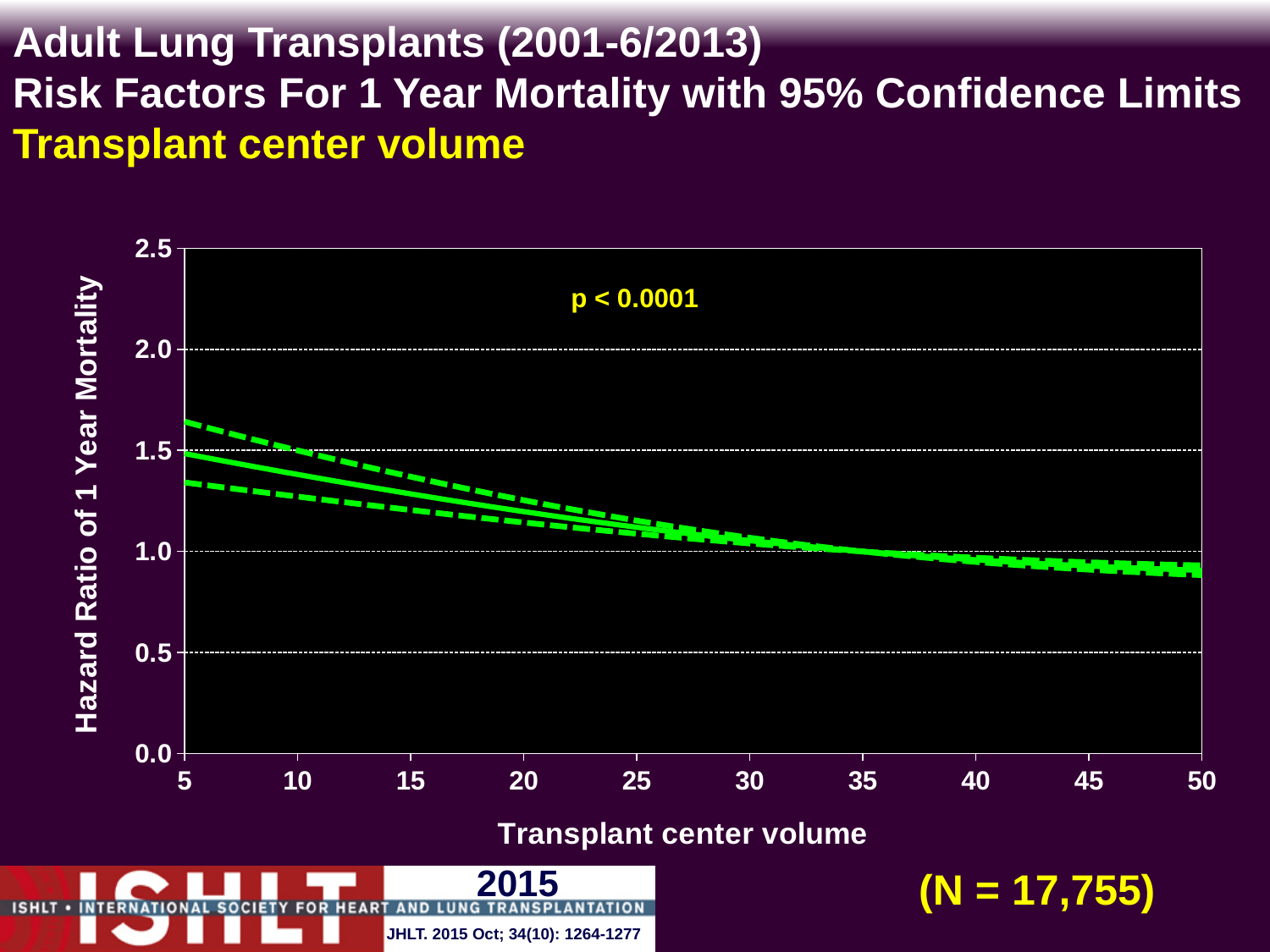
What is the highest value shown on the y axis? 2.5 What p-value is printed on the chart? p < 0.0001 Is the hazard ratio (solid line) at a transplant center volume of 5 greater or less than 1.0? greater Is the hazard ratio (solid line) at a transplant center volume of 50 greater or less than 1.0? less How many lines are plotted on the chart? 3 Does the hazard ratio of 1 year mortality rise or fall as transplant center volume increases? fall What kind of chart is shown on the slide? line chart What is the label of the x axis? Transplant center volume What is the sample size (N) shown on the slide? N = 17,755 Is the hazard ratio (solid line) at a transplant center volume of 20 greater or less than 1.5? less